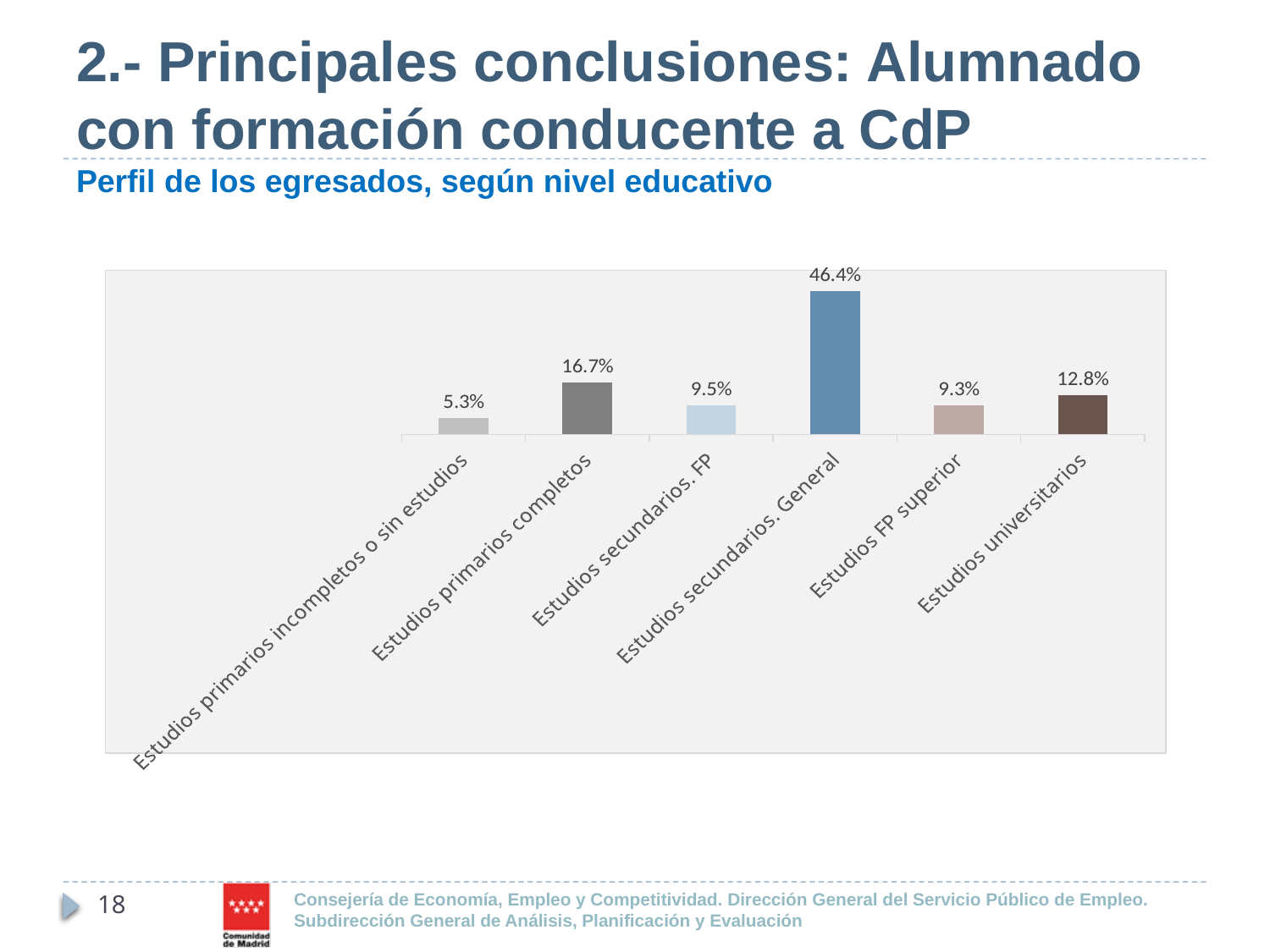
What is the value for Estudios universitarios? 12.8% What is the value for Estudios primarios incompletos o sin estudios? 5.3% Which category has the highest value? Estudios secundarios. General What kind of chart is shown on the slide? Bar chart Which is larger, Estudios secundarios. FP or Estudios universitarios? Estudios universitarios Which category has the lowest value? Estudios primarios incompletos o sin estudios How many categories are shown in the chart? 6 What is the subtitle describing the chart? Perfil de los egresados, según nivel educativo What is the value for Estudios primarios completos? 16.7% What is the difference between Estudios secundarios. General and Estudios primarios completos? 29.7% What is the difference between Estudios universitarios and Estudios FP superior? 3.5% What is the value for Estudios secundarios. General? 46.4%